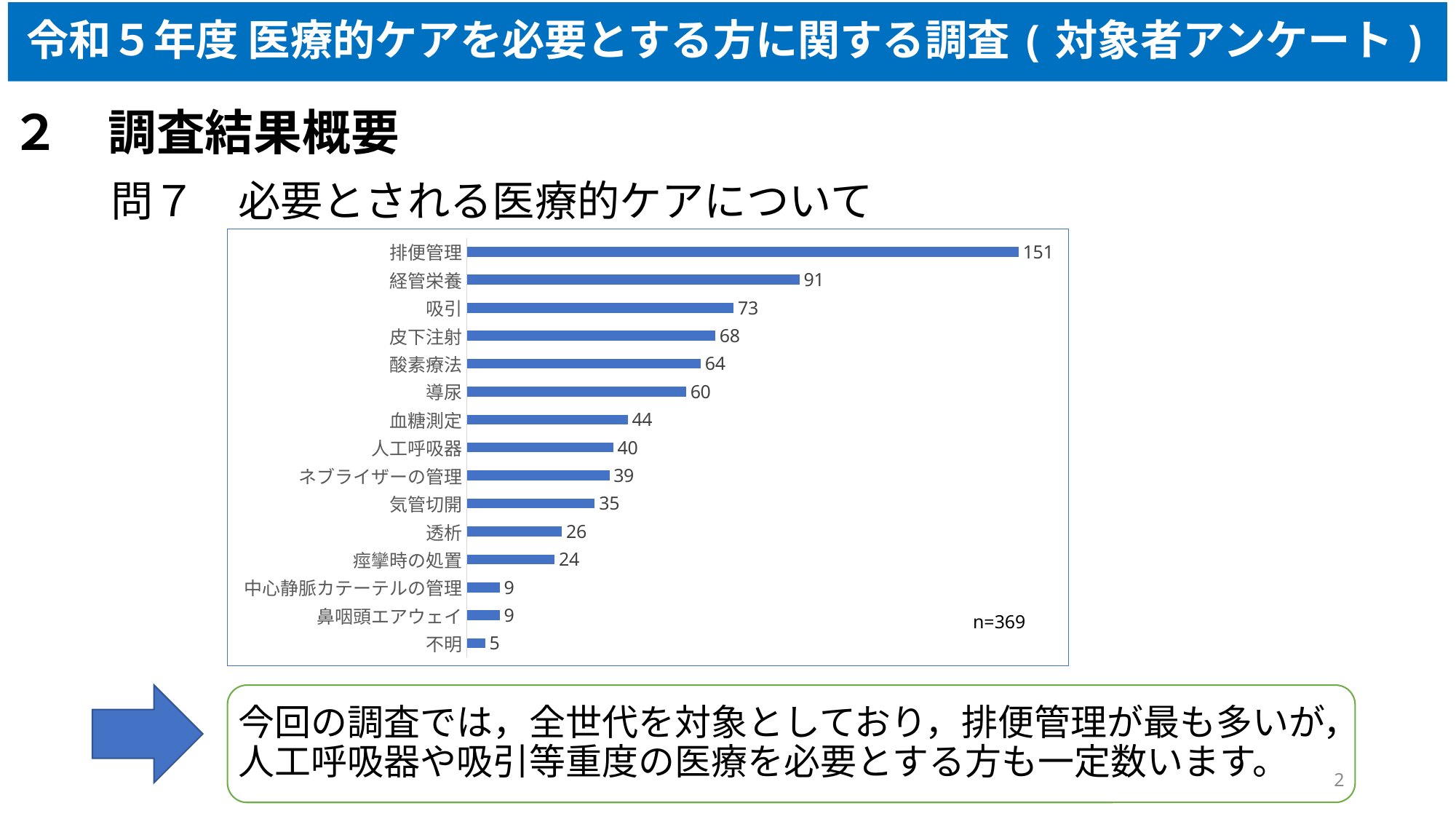
How many categories are shown in the chart? 15 What is the value for 人工呼吸器? 40 What is the value for 気管切開? 35 What kind of chart is shown on the slide? Bar chart What is the difference between the values for 排便管理 and 経管栄養? 60 What is the difference between the values for 吸引 and 透析? 47 Which category has the highest value? 排便管理 Which is larger, the value for 酸素療法 or the value for 血糖測定? 酸素療法 What is the value for 痙攣時の処置? 24 What sample size (n) is shown on the chart? n=369 What is the value for 排便管理? 151 Which category has the lowest value? 不明